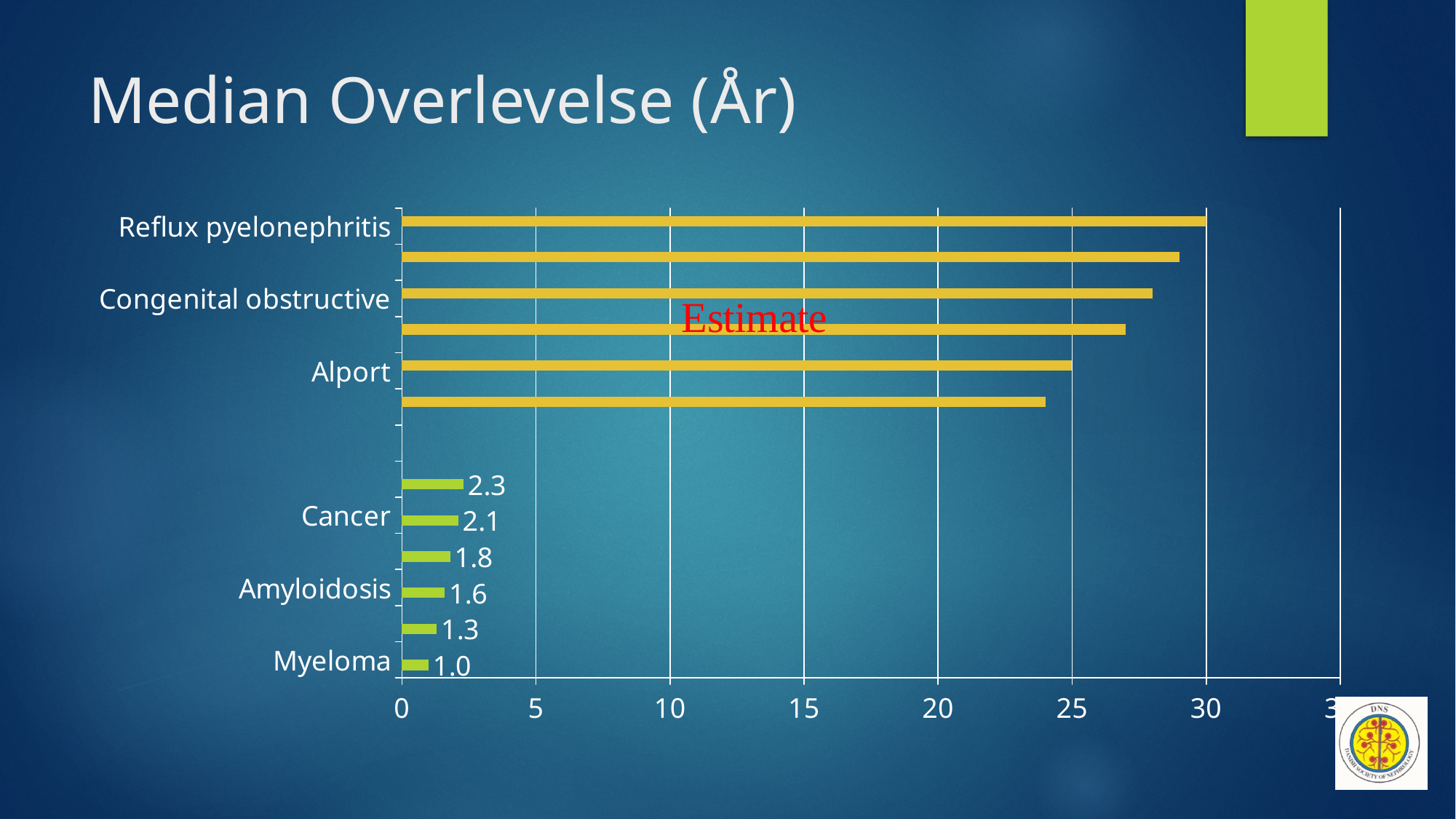
What is the value shown for Cancer? 2.1 What is the value shown for Amyloidosis? 1.6 What is the difference between the values for Cancer and Myeloma? 1.1 Which has the larger value, Cancer or Amyloidosis? Cancer Which labelled category has the highest value? Reflux pyelonephritis Which labelled category has the lowest value? Myeloma Is the value for Congenital obstructive greater or less than 25? greater Is the value for Alport greater or less than 20? greater What is the value shown for Myeloma? 1.0 What is the difference between the values for Amyloidosis and Myeloma? 0.6 What kind of chart is shown on the slide? bar chart What is the title of the chart on the slide? Median Overlevelse (År)